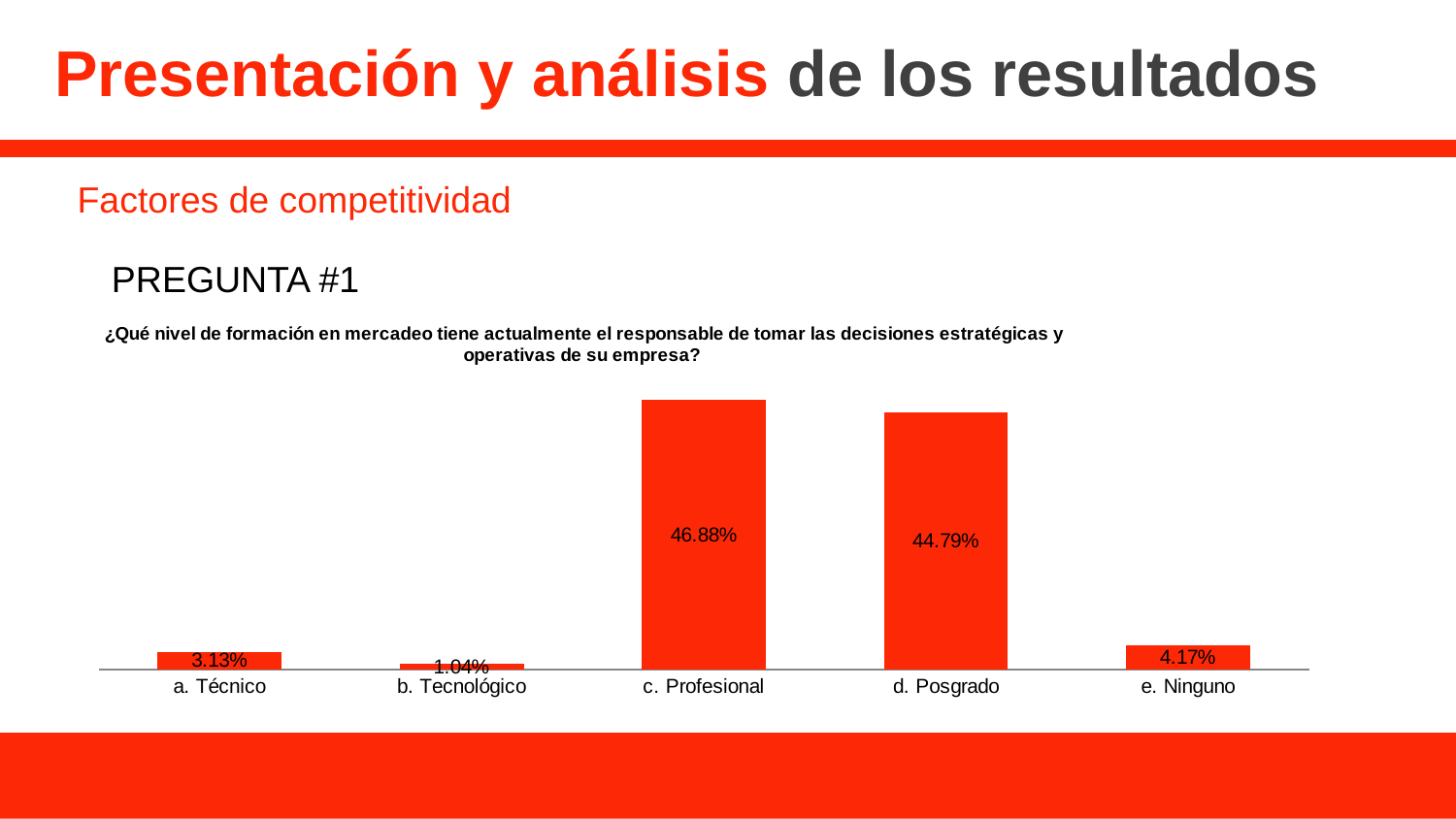
Which category has the lowest value? b. Tecnológico What is the value for a. Técnico? 3.13% What is the value for e. Ninguno? 4.17% How many categories are shown in the chart? 5 What colour are the bars in the chart? Red What is the value for b. Tecnológico? 1.04% What is the value for d. Posgrado? 44.79% What is the difference between the values for c. Profesional and d. Posgrado? 2.09% Which is larger, the value for e. Ninguno or the value for a. Técnico? e. Ninguno What is the value for c. Profesional? 46.88% What kind of chart is shown on the slide? Bar chart Which category has the highest value? c. Profesional